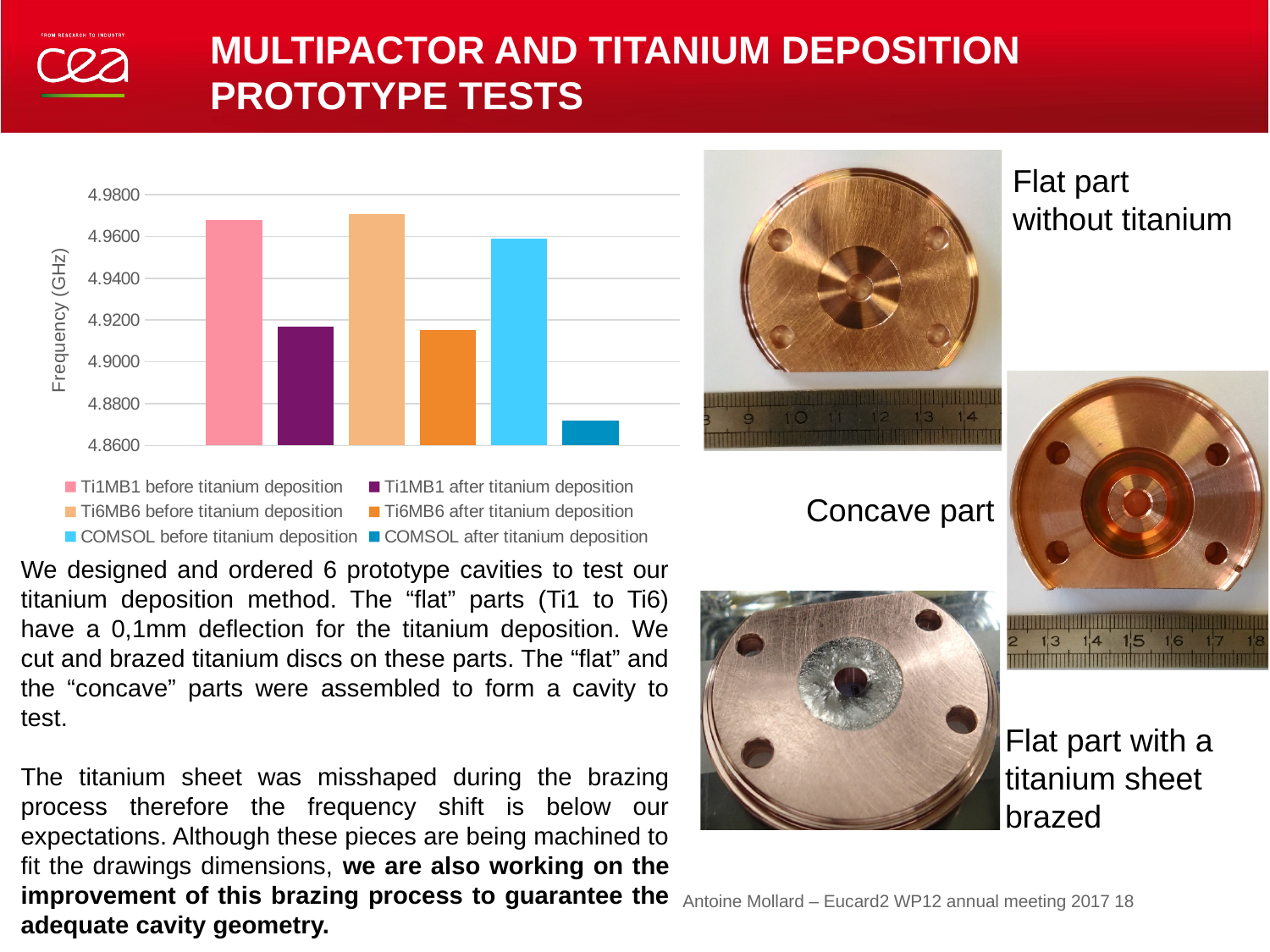
What is the label of the vertical axis of the chart? Frequency (GHz) Which series has the lowest value in the chart? COMSOL after titanium deposition How many bars are plotted in the chart? 6 Is the value for COMSOL before titanium deposition greater or less than 4.9400? greater Is the value for Ti1MB1 before titanium deposition greater or less than 4.9600? greater Which is larger, the value for Ti6MB6 before titanium deposition or Ti6MB6 after titanium deposition? Ti6MB6 before titanium deposition How many series does the chart legend list? 6 Is the value for Ti6MB6 after titanium deposition greater or less than 4.9000? greater What kind of chart is shown on the slide? bar chart Which is larger, the value for COMSOL before titanium deposition or COMSOL after titanium deposition? COMSOL before titanium deposition